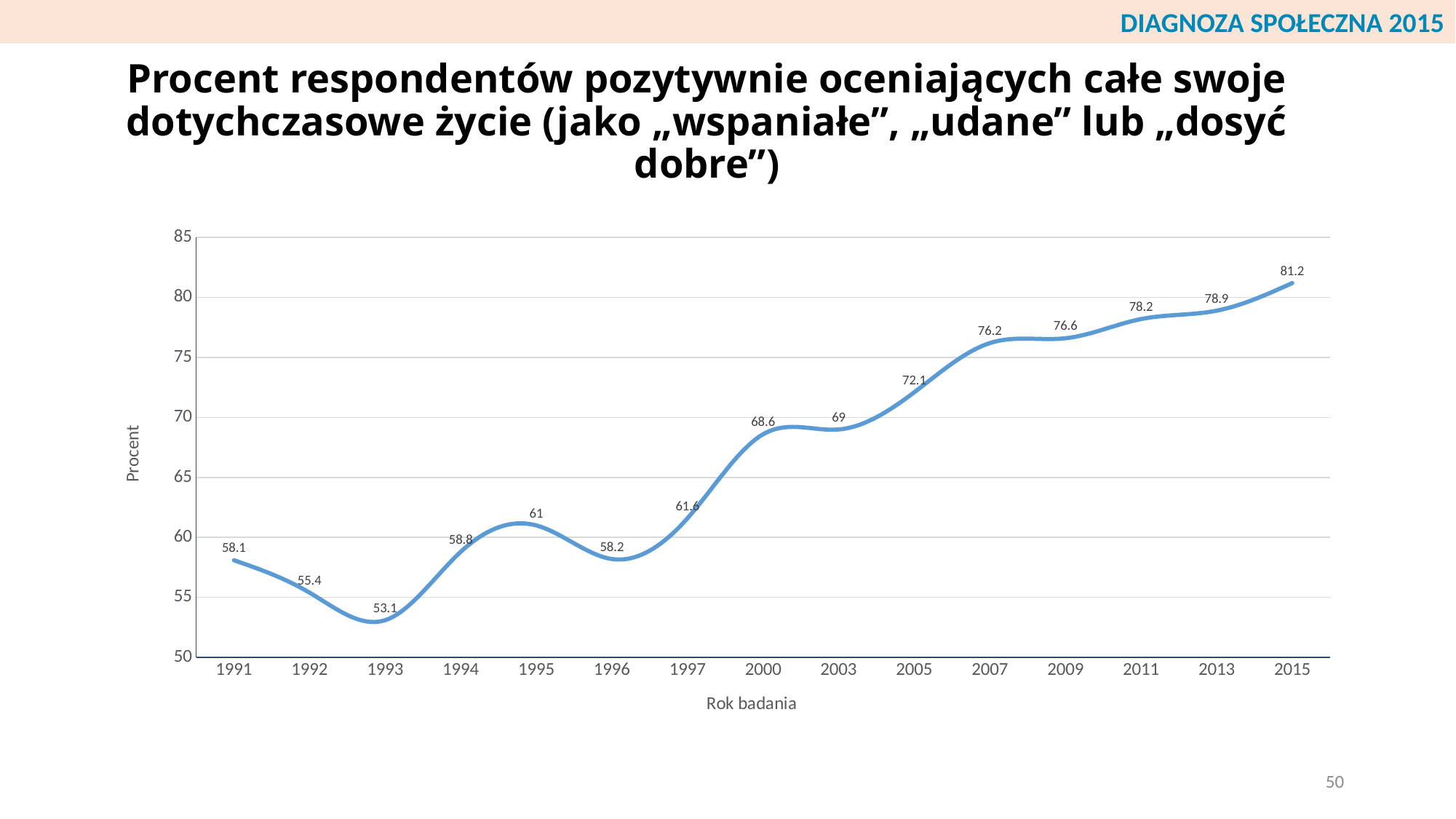
Do the values generally rise or fall from 1996 to 2015? rise Which year has the lowest value? 1993 What is the difference between the values for 2015 and 1991? 23.1 What is the value for 1993? 53.1 What is the difference between the values for 2005 and 2003? 3.1 Which year has the highest value? 2015 What is the label of the x axis? Rok badania What is the value for 2000? 68.6 What is the value for 2015? 81.2 What type of chart is shown on the slide? line chart How many years are plotted on the x axis? 15 Which is larger, the value for 1995 or the value for 1997? 1997